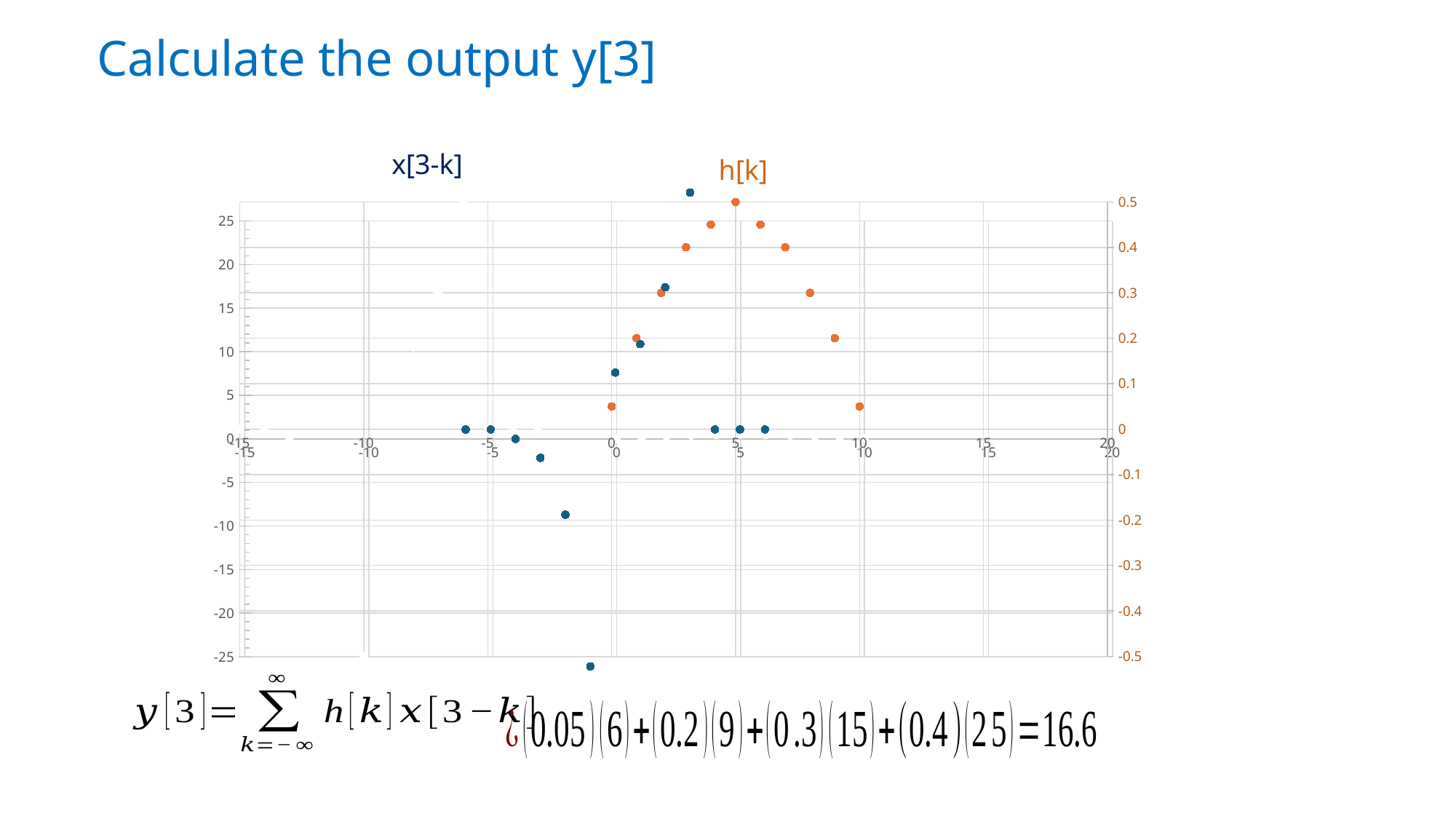
Which colour is used for the h[k] series? orange What is the value of h[k] at k = 5, read on the right-hand axis? 0.5 What are the names of the two series plotted on the chart? x[3-k] and h[k] At which value of k does the h[k] series reach its highest point? 5 What is the value of h[k] at k = 3, read on the right-hand axis? 0.4 Does the h[k] series rise or fall as k goes from 5 to 10? fall Which is larger: the value of h[k] at k = 5 or at k = 10? k = 5 What kind of chart is shown on the slide? scatter chart At which value of k does the x[3-k] series reach its lowest point? -1 How many data series are plotted on the chart? 2